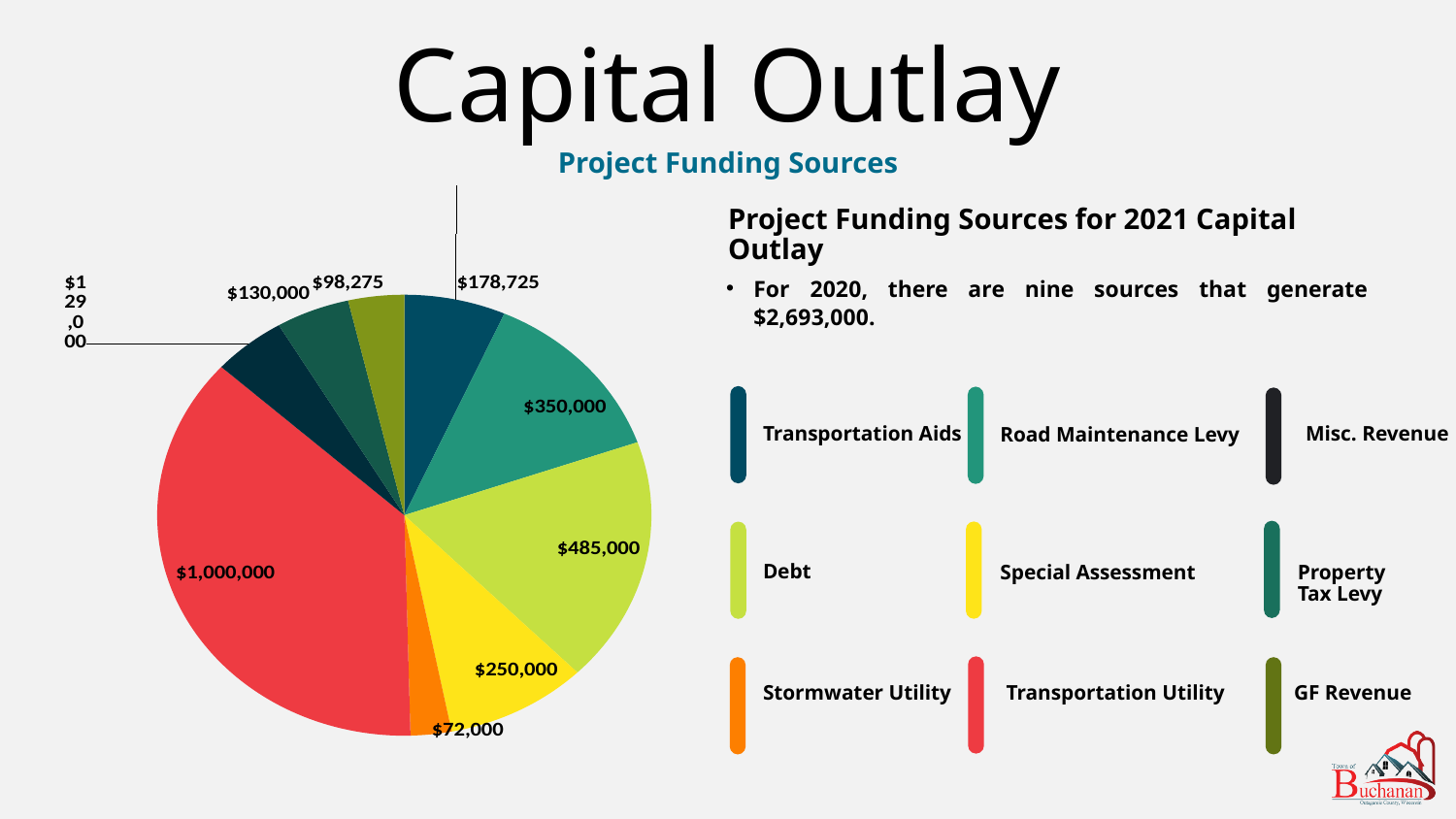
Which is larger, the Special Assessment slice or the Road Maintenance Levy slice? Road Maintenance Levy How many entries does the legend list? 9 Which funding source has the largest slice? Transportation Utility Which funding source has the smallest slice? Stormwater Utility What is the value of the Stormwater Utility slice? $72,000 What kind of chart is shown on the slide? Pie chart What is the value of the Debt slice? $485,000 What is the title of the chart? Project Funding Sources What is the total of all the slices in the pie chart? $2,693,000 How many slices does the pie chart have? 9 What is the difference between the Debt slice and the Road Maintenance Levy slice? $135,000 What is the value of the Transportation Utility slice? $1,000,000